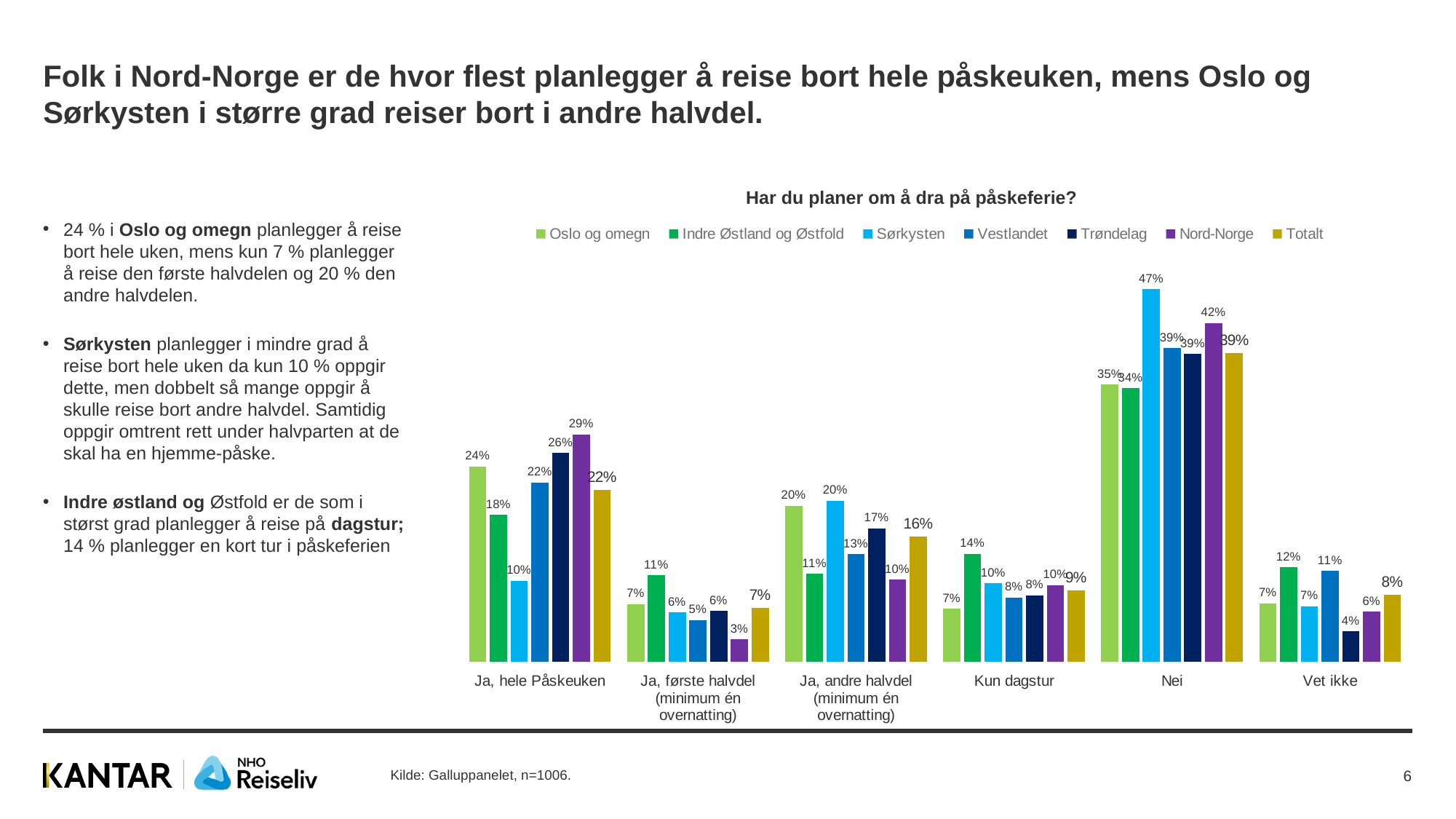
How many categories are shown on the x axis? 6 What is the title of the chart? Har du planer om å dra på påskeferie? How many series does the legend list? 7 What is the difference between Nord-Norge and Sørkysten in the "Ja, hele Påskeuken" category? 19 percentage points Which region has the highest value in the "Kun dagstur" category? Indre Østland og Østfold What is the value for Nord-Norge in the "Ja, hele Påskeuken" category? 29% What is the value for Totalt in the "Ja, andre halvdel (minimum én overnatting)" category? 16% What is the value for Trøndelag in the "Vet ikke" category? 4% What kind of chart is shown on the slide? Bar chart Which region has the lowest value in the "Ja, første halvdel (minimum én overnatting)" category? Nord-Norge What is the value for Sørkysten in the "Nei" category? 47% Which is larger in the "Nei" category: Oslo og omegn or Nord-Norge? Nord-Norge